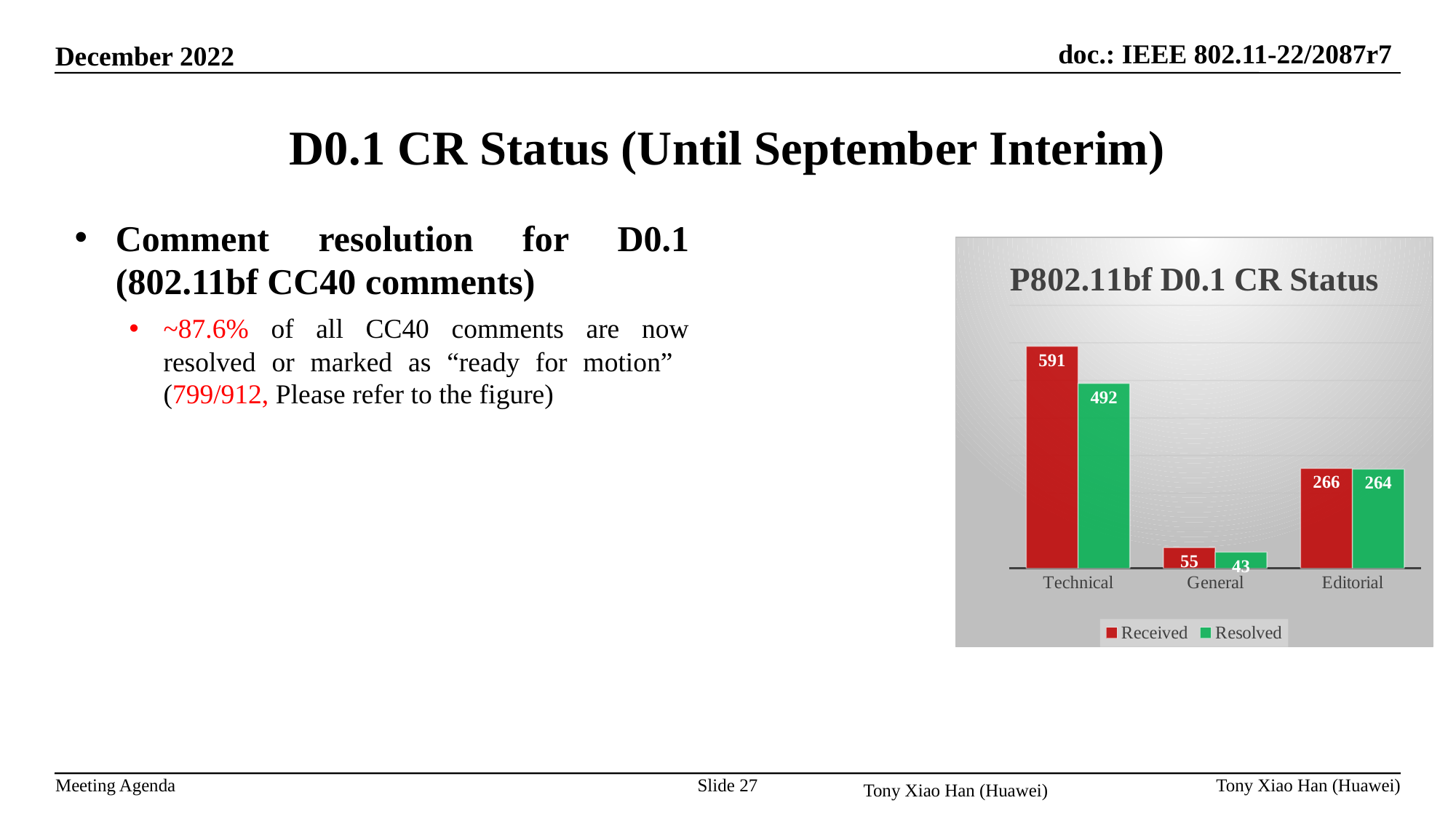
How many categories are shown on the x axis? 3 What is the difference between Received and Resolved for General? 12 Which category has the highest Received value? Technical What is the difference between Received and Resolved for Technical? 99 How many series does the legend list? 2 What is the Resolved value for Editorial? 264 Which is larger, the Resolved value for Technical or the Received value for Editorial? Resolved value for Technical Which category has the lowest Resolved value? General What is the Received value for Technical? 591 What is the Resolved value for General? 43 What is the title of the chart? P802.11bf D0.1 CR Status What kind of chart is shown? Bar chart